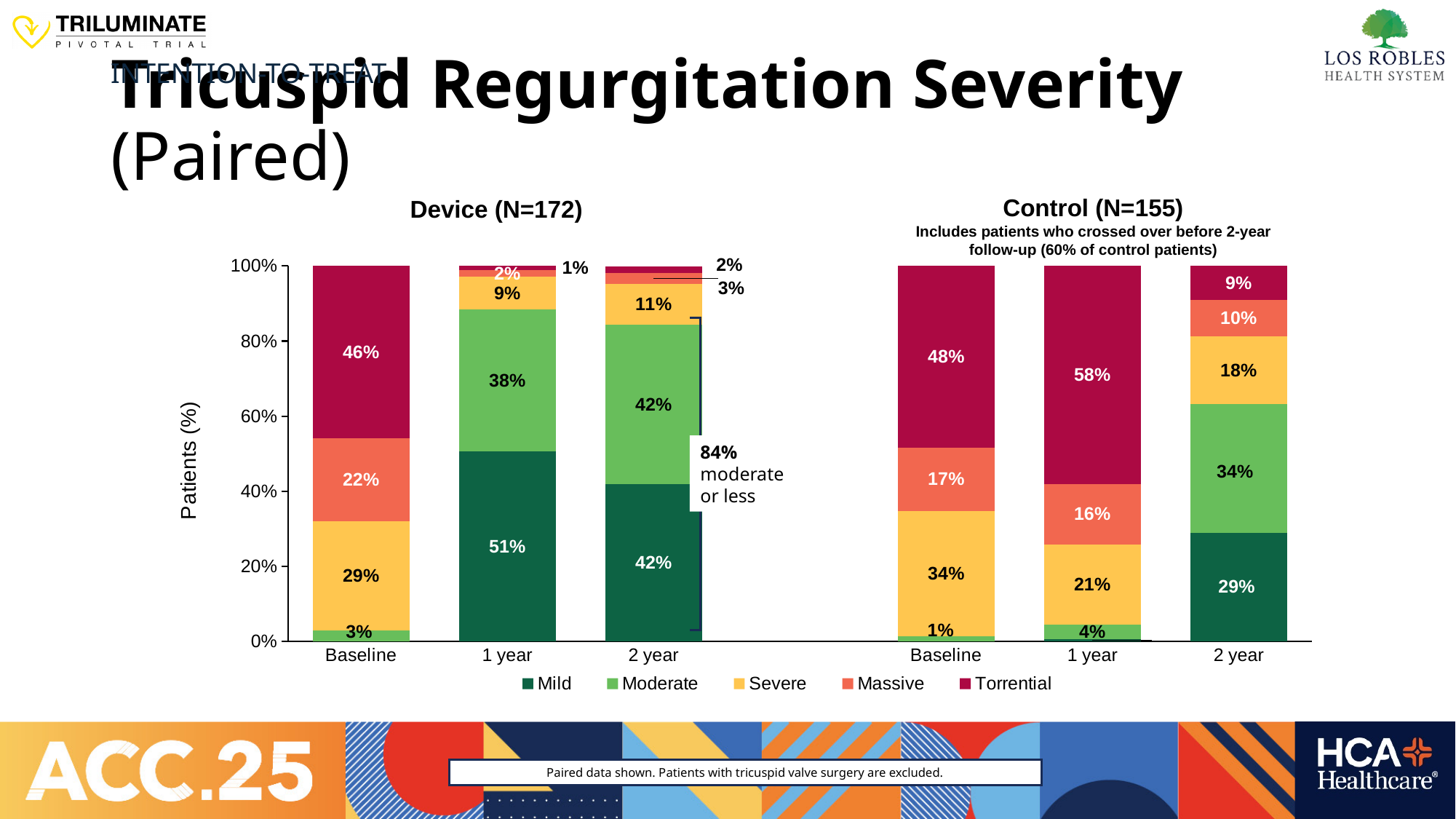
In the Device (N=172) chart, what percentage of patients at 2 year is annotated as having moderate or less tricuspid regurgitation? 84% In the Control (N=155) chart, what percentage of patients had Torrential tricuspid regurgitation at 1 year? 58% In the Device (N=172) chart, what percentage of patients had Mild tricuspid regurgitation at 1 year? 51% How many series does the legend list? 5 How many time points are shown on the x axis of the Control (N=155) chart? 3 At 2 year, is the Mild percentage larger in the Device (N=172) chart or the Control (N=155) chart? Device (N=172) In the Control (N=155) chart, which time point has the highest Torrential percentage? 1 year In the Device (N=172) chart, which time point has the lowest Mild percentage? Baseline What kind of chart is the Device (N=172) chart? Stacked bar chart In the Device (N=172) chart, what percentage of patients had Torrential tricuspid regurgitation at Baseline? 46% In the Control (N=155) chart, what percentage of patients had Moderate tricuspid regurgitation at 2 year? 34%